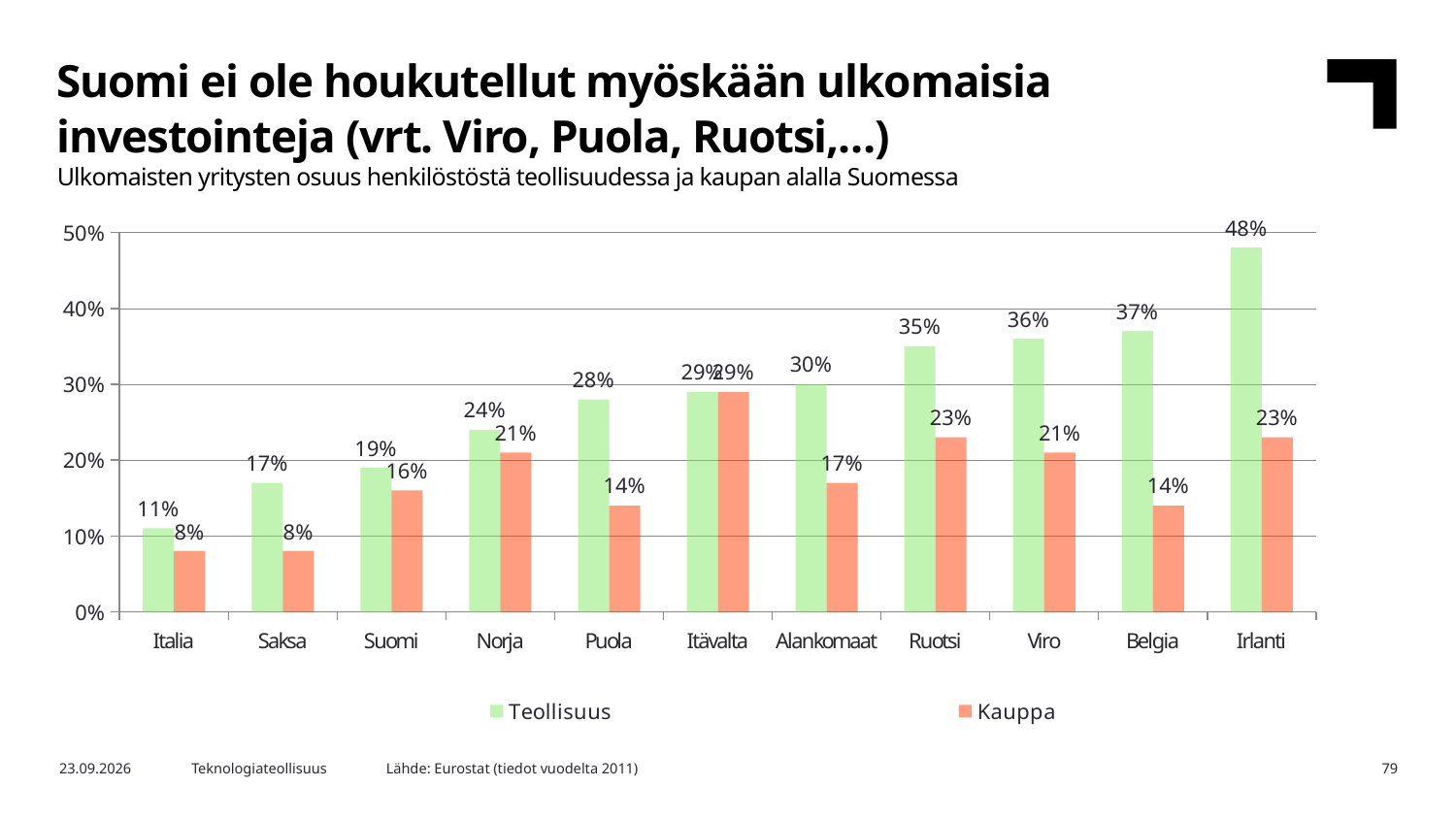
What is the Kauppa value for Ruotsi? 23% Do the Teollisuus values rise or fall from Italia to Irlanti along the x axis? Rise Which country has the highest Kauppa value? Itävalta What is the difference between the Teollisuus values for Irlanti and Suomi? 29% Which country has the highest Teollisuus value? Irlanti Which country has the lowest Teollisuus value? Italia What is the Teollisuus value for Suomi? 19% How many countries are shown on the x axis? 11 Which is larger: the Kauppa value for Norja or the Kauppa value for Puola? Norja Is the Teollisuus value for Viro greater or less than 30%? greater What kind of chart is shown on the slide? Bar chart How many series does the legend list? 2